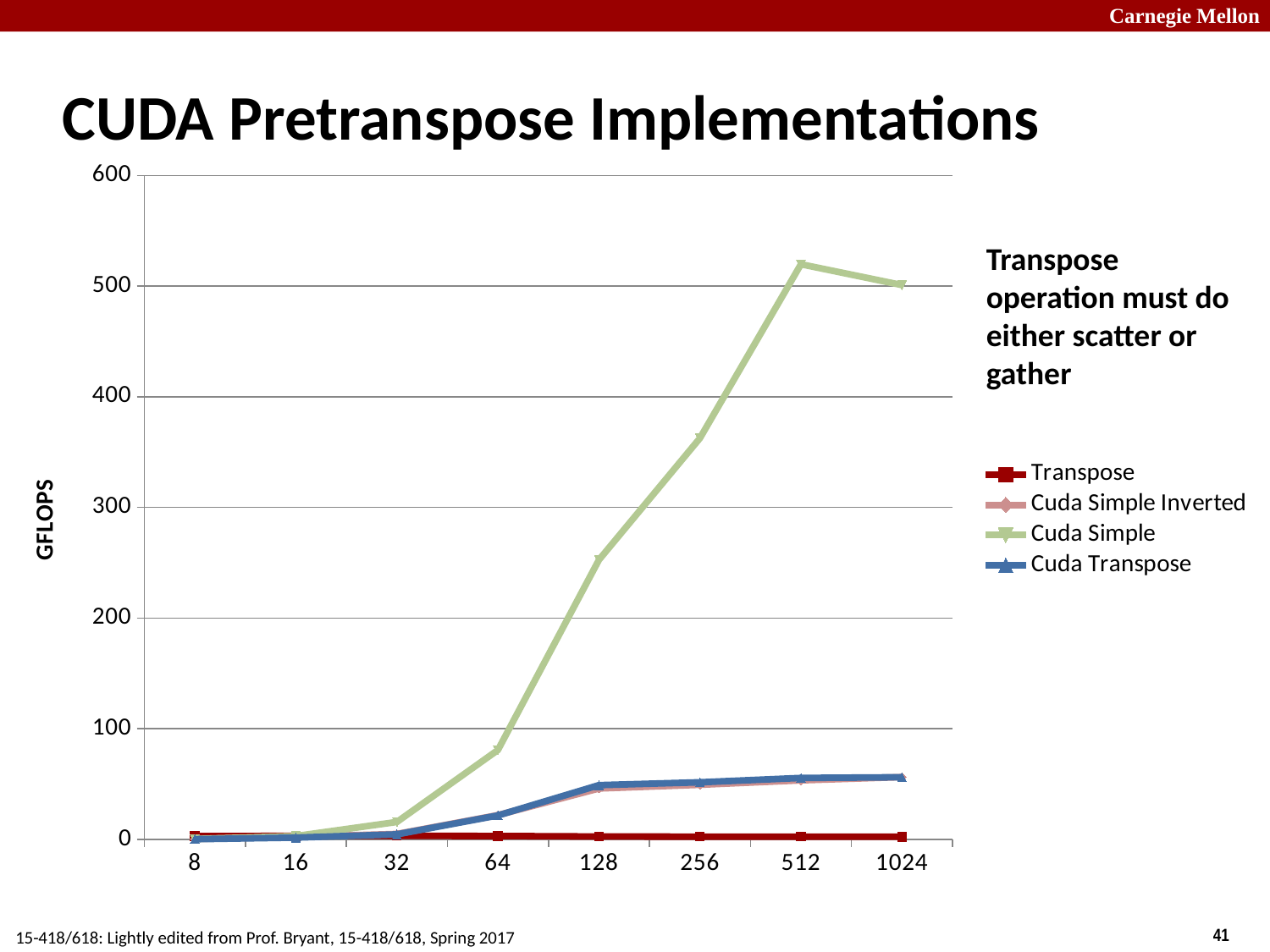
What is the label on the y-axis? GFLOPS Does the Cuda Simple series generally rise or fall from x = 8 to x = 512? rise Which is larger at x = 256: Cuda Simple or Cuda Transpose? Cuda Simple Is the value for Cuda Simple at x = 128 greater or less than 300? less How many x-axis categories are plotted in the chart? 8 What is the title of the chart? CUDA Pretranspose Implementations What kind of chart is shown on the slide? line chart Is the value for Cuda Simple at x = 512 greater or less than 500? greater Is the value for Cuda Transpose at x = 1024 greater or less than 100? less Which series has the lowest value at x = 1024? Transpose Which series has the highest value at x = 1024? Cuda Simple How many series does the legend list? 4